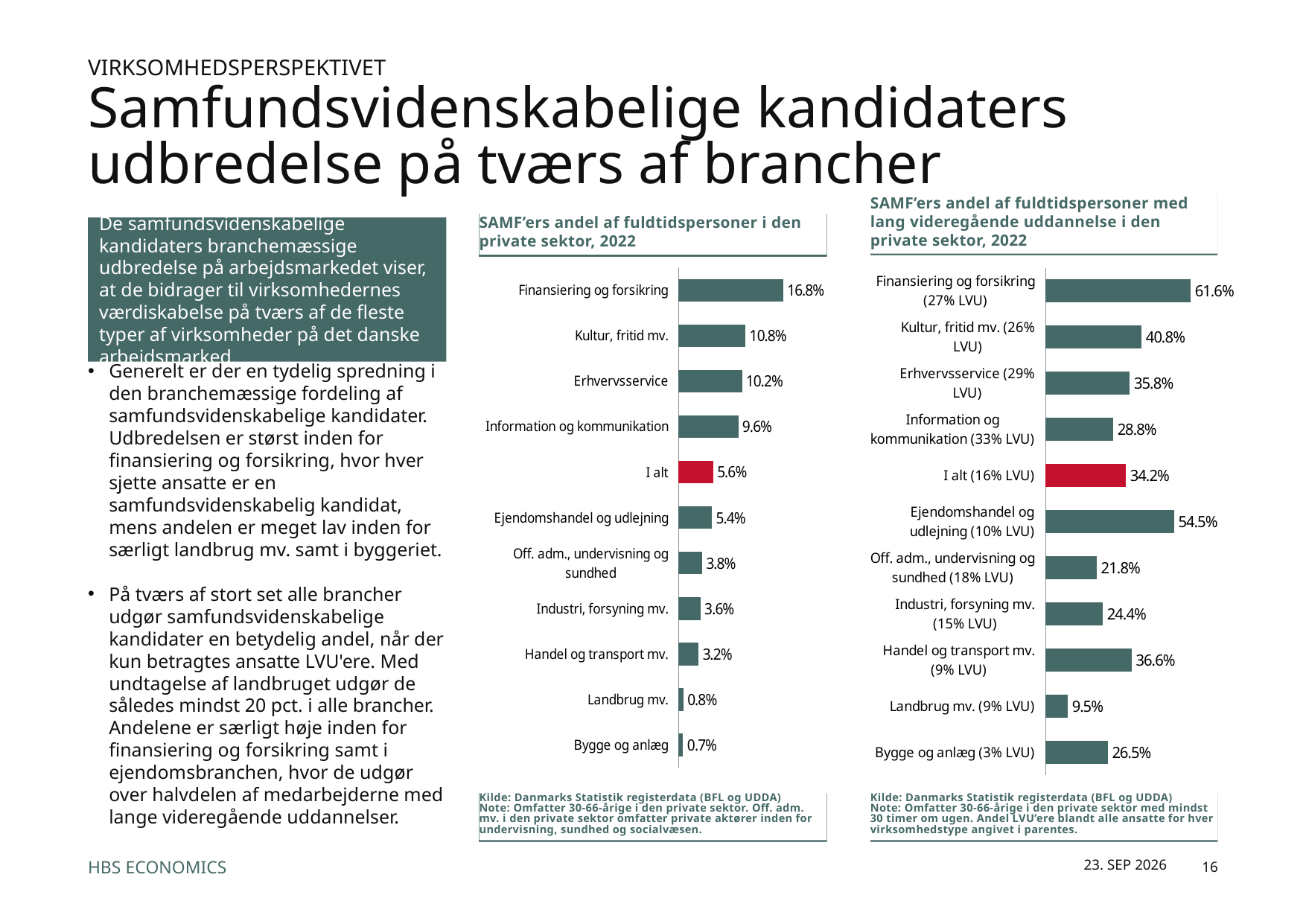
In the left chart (SAMF'ers andel af fuldtidspersoner i den private sektor, 2022), which category has the lowest value? Bygge og anlæg In the left chart (SAMF'ers andel af fuldtidspersoner i den private sektor, 2022), what is the value for I alt? 5.6% What type of chart is the left chart (SAMF'ers andel af fuldtidspersoner i den private sektor, 2022)? Bar chart In the left chart (SAMF'ers andel af fuldtidspersoner i den private sektor, 2022), what is the difference between Finansiering og forsikring and Kultur, fritid mv.? 6.0% In the right chart (SAMF'ers andel af fuldtidspersoner med lang videregående uddannelse i den private sektor, 2022), which category has the lowest value? Landbrug mv. (9% LVU) In the right chart (SAMF'ers andel af fuldtidspersoner med lang videregående uddannelse i den private sektor, 2022), what is the difference between Finansiering og forsikring (27% LVU) and I alt (16% LVU)? 27.4% In the left chart (SAMF'ers andel af fuldtidspersoner i den private sektor, 2022), how many categories are shown? 11 In the right chart (SAMF'ers andel af fuldtidspersoner med lang videregående uddannelse i den private sektor, 2022), which bar is coloured red? I alt (16% LVU) In the right chart (SAMF'ers andel af fuldtidspersoner med lang videregående uddannelse i den private sektor, 2022), which is larger: Handel og transport mv. (9% LVU) or Erhvervsservice (29% LVU)? Handel og transport mv. (9% LVU) In the right chart (SAMF'ers andel af fuldtidspersoner med lang videregående uddannelse i den private sektor, 2022), what is the value for Ejendomshandel og udlejning (10% LVU)? 54.5% In the right chart (SAMF'ers andel af fuldtidspersoner med lang videregående uddannelse i den private sektor, 2022), which category has the highest value? Finansiering og forsikring (27% LVU) In the left chart (SAMF'ers andel af fuldtidspersoner i den private sektor, 2022), what is the value for Finansiering og forsikring? 16.8%